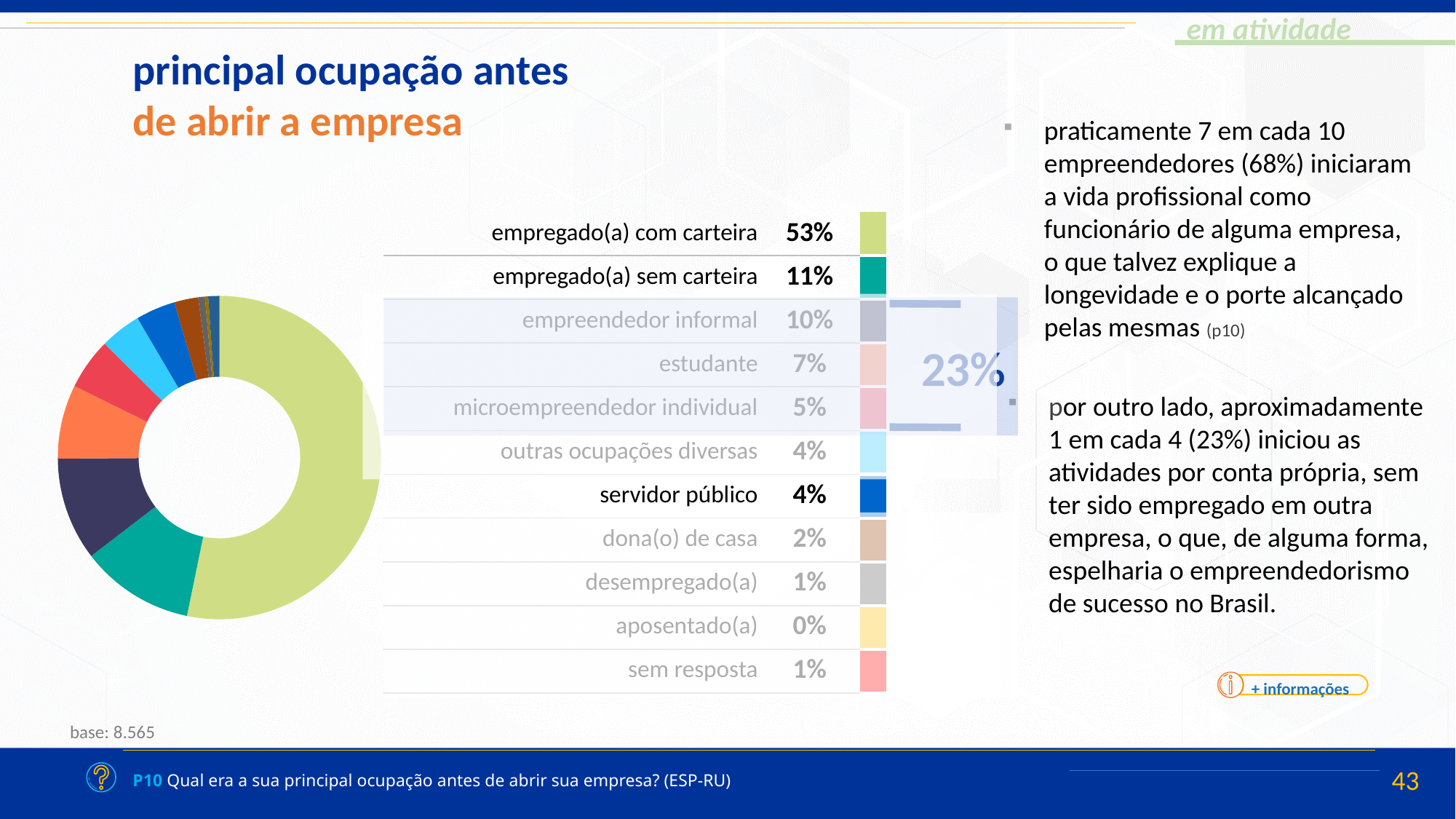
What percentage is shown for 'empreendedor informal'? 10% What kind of chart is shown on the slide? pie chart (donut) What percentage is shown for 'empregado(a) com carteira'? 53% What is the difference in percentage points between 'empregado(a) com carteira' and 'empregado(a) sem carteira'? 42 percentage points Which is larger, the value for 'estudante' or for 'microempreendedor individual'? estudante How many categories are listed in the chart? 11 What is the base (number of respondents) shown for the chart? 8.565 Which category has the lowest percentage? aposentado(a) Which category has the highest percentage? empregado(a) com carteira What share of the pie does 'empregado(a) com carteira' represent? 53% What percentage is shown for 'dona(o) de casa'? 2% What percentage is shown for 'servidor público'? 4%